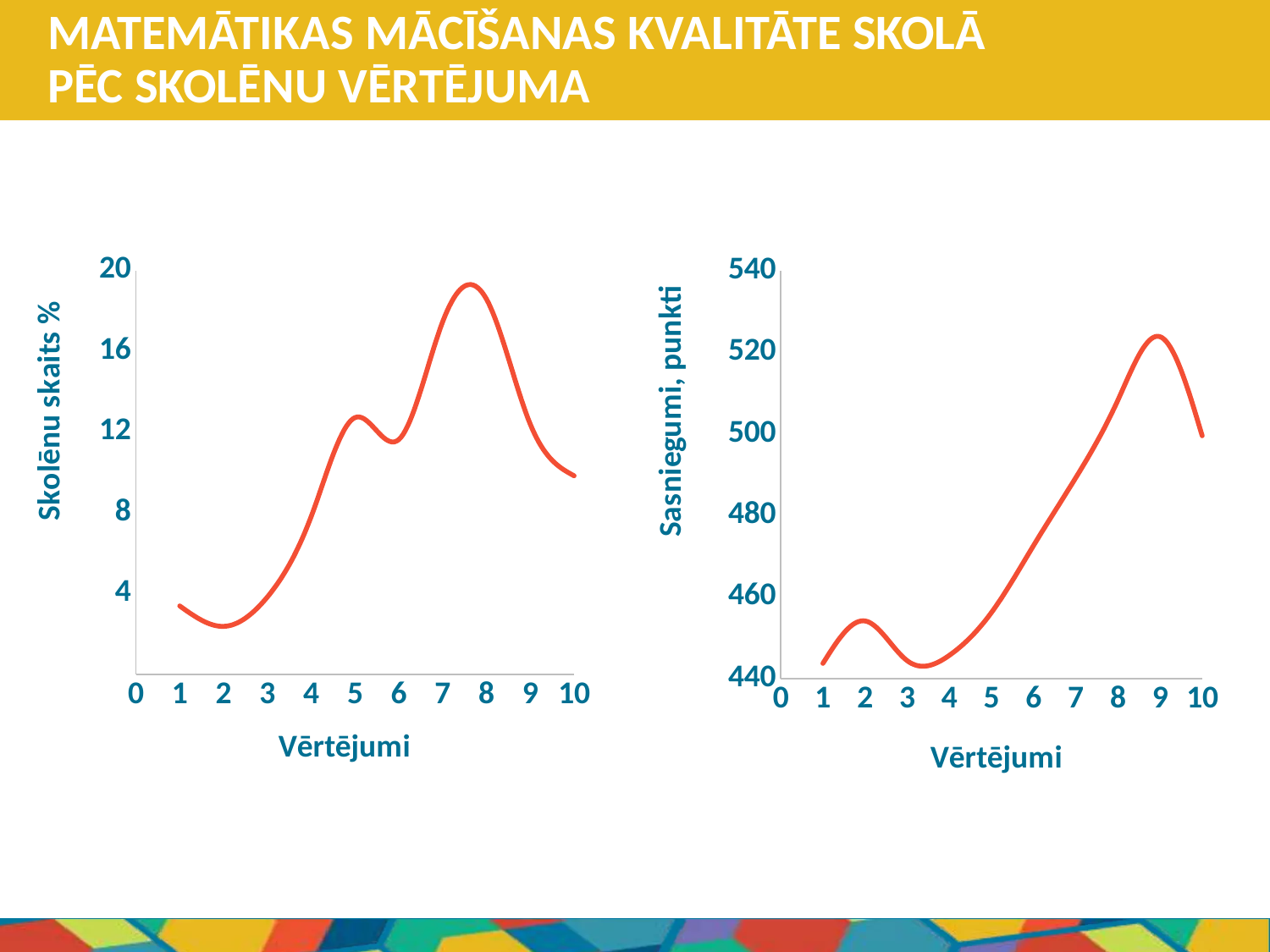
In the left chart (Skolēnu skaits %), at which Vērtējums is the value lowest? 2 What is the y-axis label of the right chart? Sasniegumi, punkti In the left chart (Skolēnu skaits %), is the value at Vērtējums 2 greater or less than 4? less In the right chart (Sasniegumi, punkti), is the value at Vērtējums 9 greater or less than 500? greater What kind of chart is the left chart (Skolēnu skaits %)? line chart In the right chart (Sasniegumi, punkti), is the value at Vērtējums 5 greater or less than 480? less In the right chart (Sasniegumi, punkti), do the values rise or fall from Vērtējums 4 to Vērtējums 9? rise What kind of chart is the right chart (Sasniegumi, punkti)? line chart In the left chart (Skolēnu skaits %), which is larger: the value at Vērtējums 8 or at Vērtējums 5? Vērtējums 8 In the right chart (Sasniegumi, punkti), at which Vērtējums is the value highest? 9